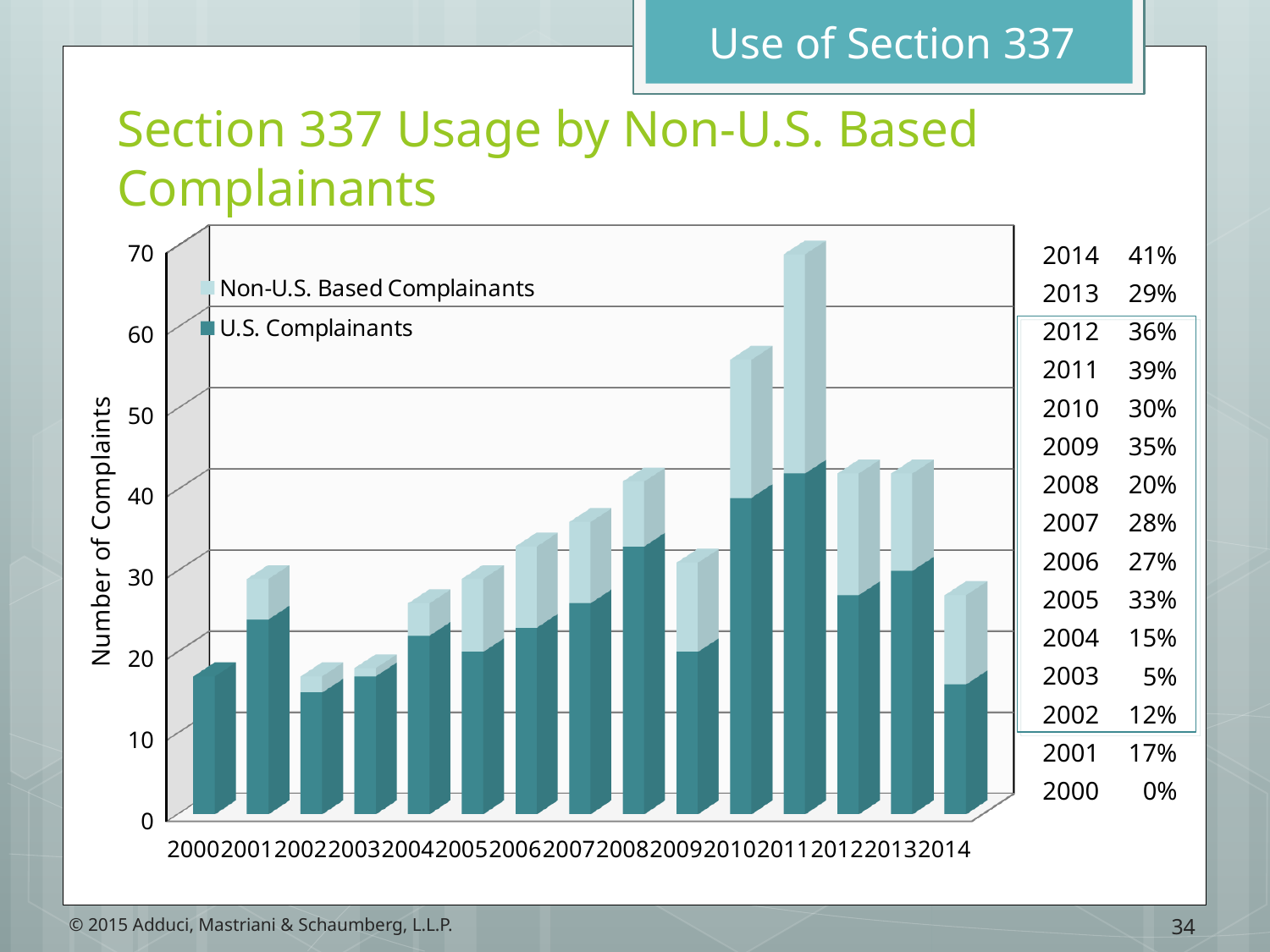
Is the total number of complaints for 2011 greater or less than 60? greater How many years are shown along the x axis of the chart? 15 Do the total complaints rise or fall from 2009 to 2011? rise Is the total number of complaints for 2010 greater or less than 50? greater What is the label on the vertical axis of the chart? Number of Complaints Which year has the larger total number of complaints, 2010 or 2012? 2010 Which year has the larger total number of complaints, 2001 or 2002? 2001 How many series does the chart's legend list? 2 Which year has the highest total number of complaints? 2011 Is the total number of complaints for 2014 greater or less than 30? less What kind of chart is shown on the slide? bar chart